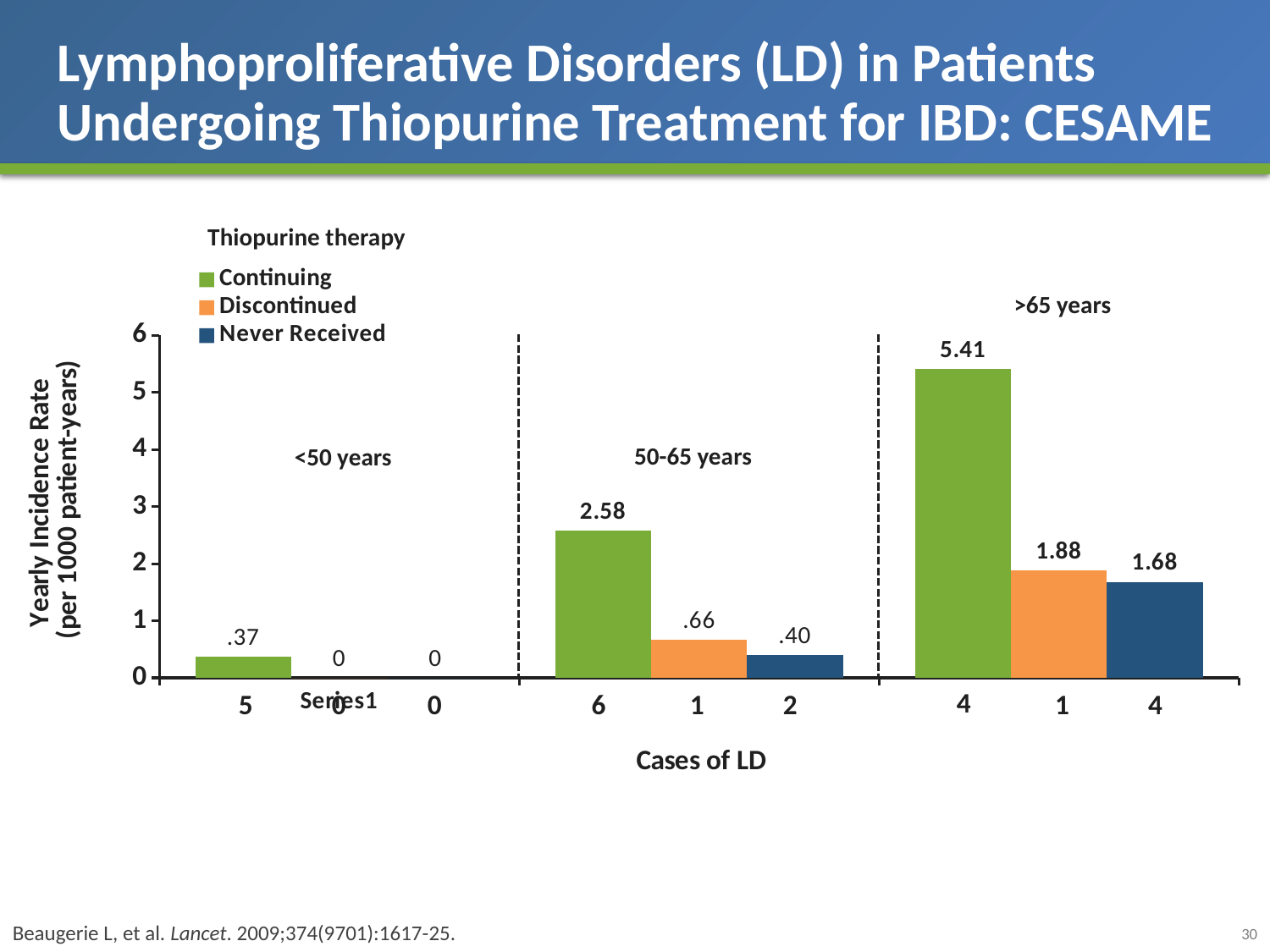
Which age group has the highest yearly incidence rate for patients continuing thiopurine therapy? >65 years What is the yearly incidence rate for patients who never received thiopurine therapy in the >65 years group? 1.68 In the 50-65 years group, which has a higher yearly incidence rate: discontinued or never received thiopurine therapy? Discontinued What is the yearly incidence rate for patients continuing thiopurine therapy in the <50 years group? .37 What is the yearly incidence rate for patients who discontinued thiopurine therapy in the 50-65 years group? .66 What is the yearly incidence rate for patients continuing thiopurine therapy in the >65 years group? 5.41 How many series does the legend list? 3 What kind of chart is shown on the slide? Bar chart What is the difference in yearly incidence rate between continuing and discontinued thiopurine therapy in the >65 years group? 3.53 How many cases of LD were there among patients continuing thiopurine therapy in the 50-65 years group? 6 Is the yearly incidence rate for continuing thiopurine therapy in the >65 years group greater or less than 5? greater What is the difference in yearly incidence rate between continuing and never received thiopurine therapy in the 50-65 years group? 2.18